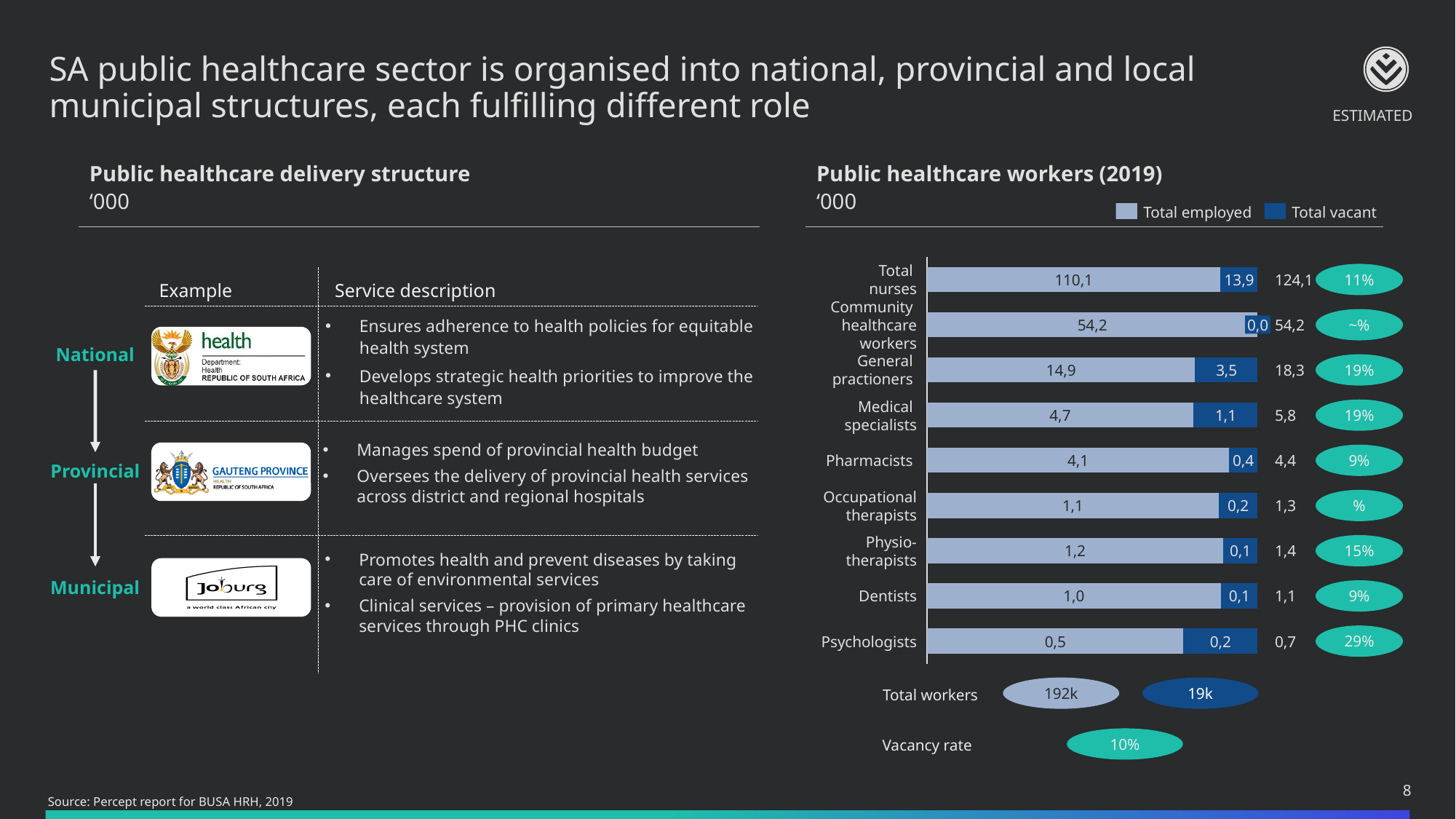
How many categories are shown in the chart? 9 How many series does the legend list? 2 What is the difference between the Total employed values for General practioners and Medical specialists? 10,2 Which category has the highest Total employed value? Total nurses Which is larger, the Total vacant value for Medical specialists or for Pharmacists? Medical specialists What is the Total employed value for Pharmacists? 4,1 What is the Total vacant value for Psychologists? 0,2 What is the Total employed value for Total nurses? 110,1 What is the Total vacant value for General practioners? 3,5 What kind of chart is shown? Stacked bar chart What is the total of the stacked bar for Medical specialists? 5,8 Which category has the lowest Total employed value? Psychologists